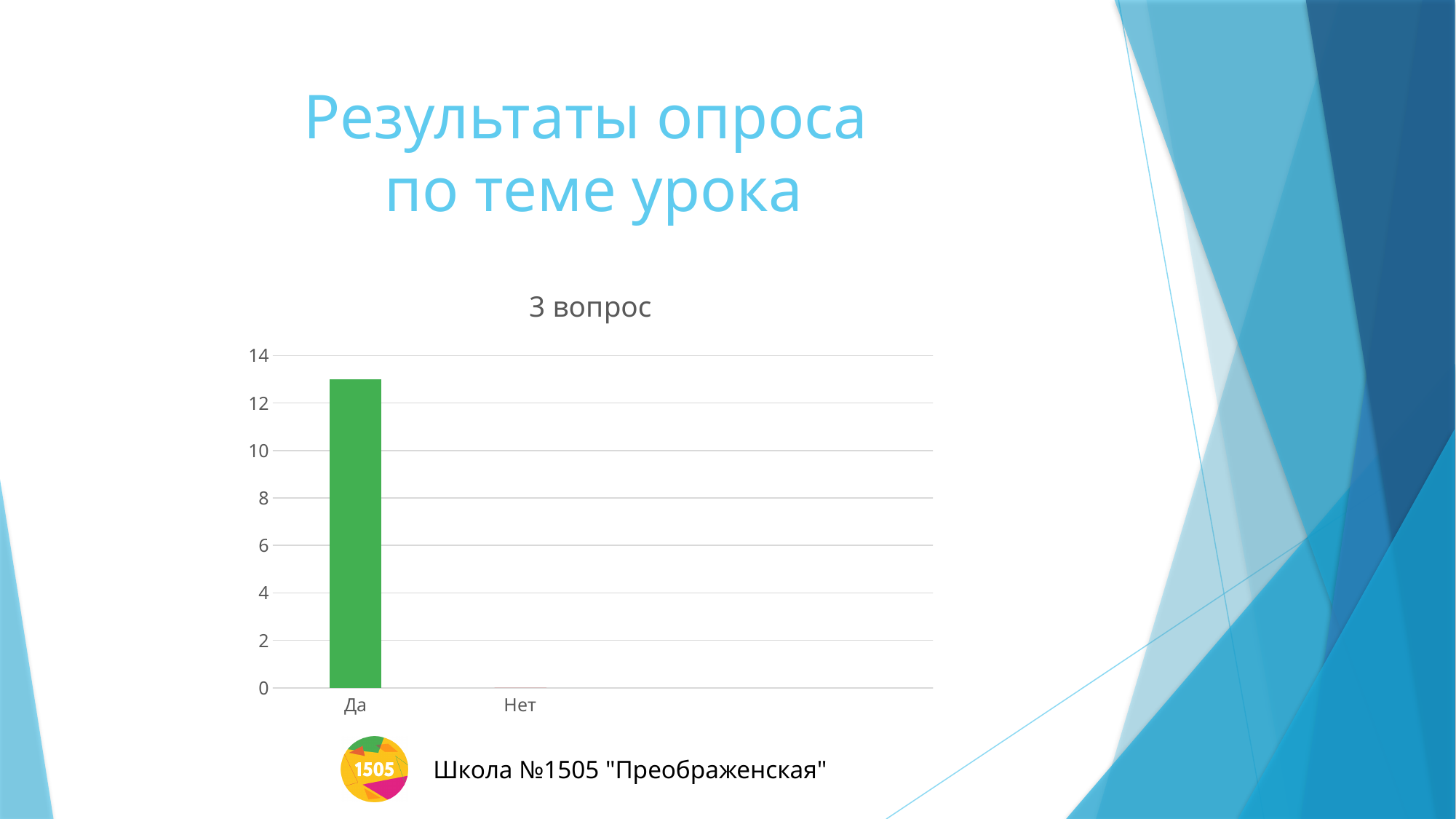
What colour is the bar for Да? green Is the value for Нет greater or less than 2? less What is the title of the chart? 3 вопрос Is the value for Да greater or less than 10? greater Is the value for Да greater or less than 12? greater Which is larger, the value for Да or the value for Нет? Да Which category has the highest value? Да Which category has the lowest value? Нет How many categories are shown on the x axis of the chart? 2 What kind of chart is shown on the slide? bar chart Do the values rise or fall from Да to Нет along the x axis? fall